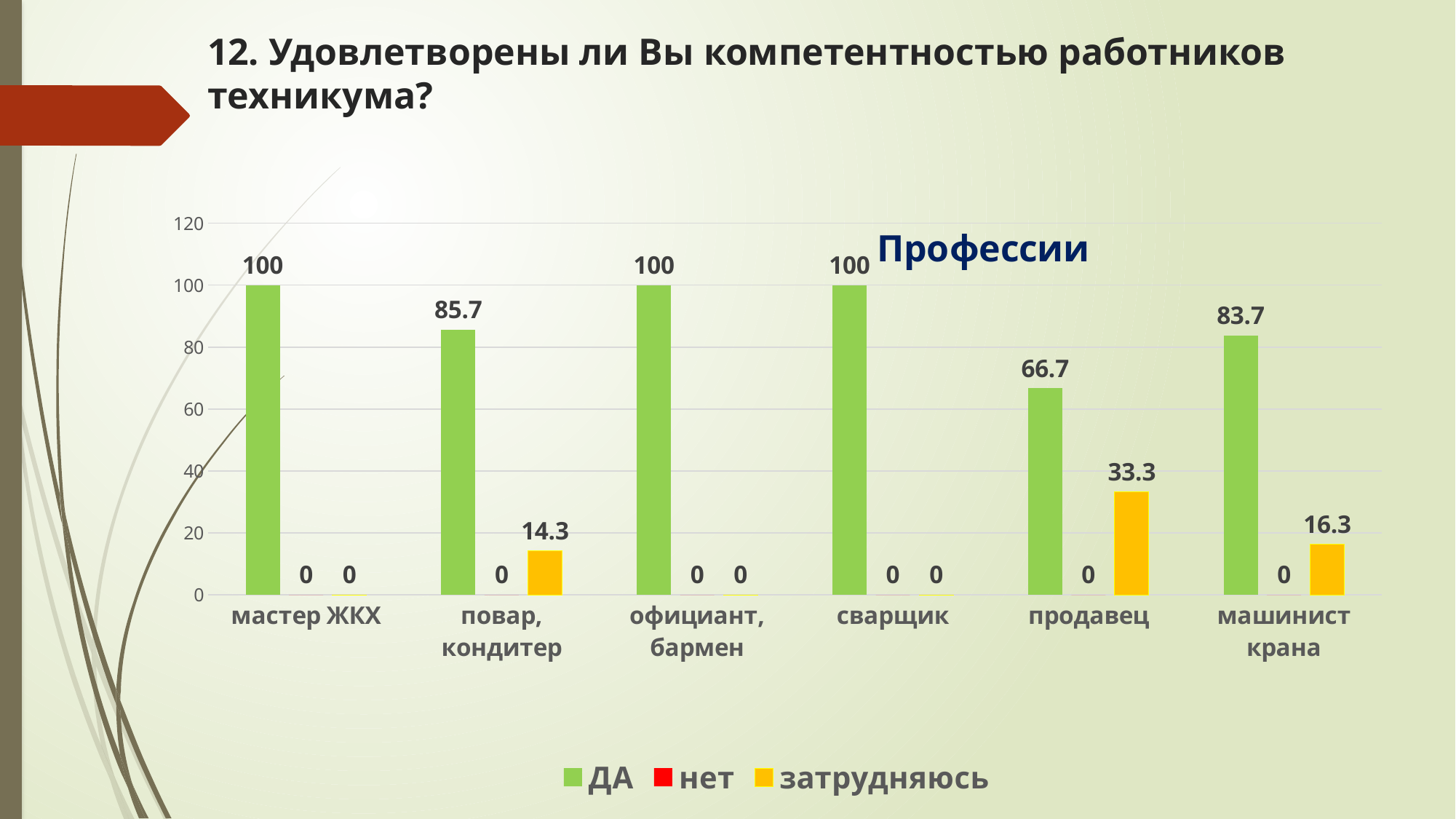
Which category has the lowest value in the ДА series? продавец What is the value of the затрудняюсь series for повар, кондитер? 14.3 Which is larger: the затрудняюсь value for машинист крана or for повар, кондитер? машинист крана How many series does the legend list? 3 What is the title of the chart? Профессии How many categories are shown on the x axis? 6 What is the value of the ДА series for продавец? 66.7 What is the value of the ДА series for машинист крана? 83.7 What is the value of the нет series for сварщик? 0 Which category has the highest value in the затрудняюсь series? продавец What kind of chart is shown on the slide? bar chart What is the difference between the ДА values for повар, кондитер and продавец? 19